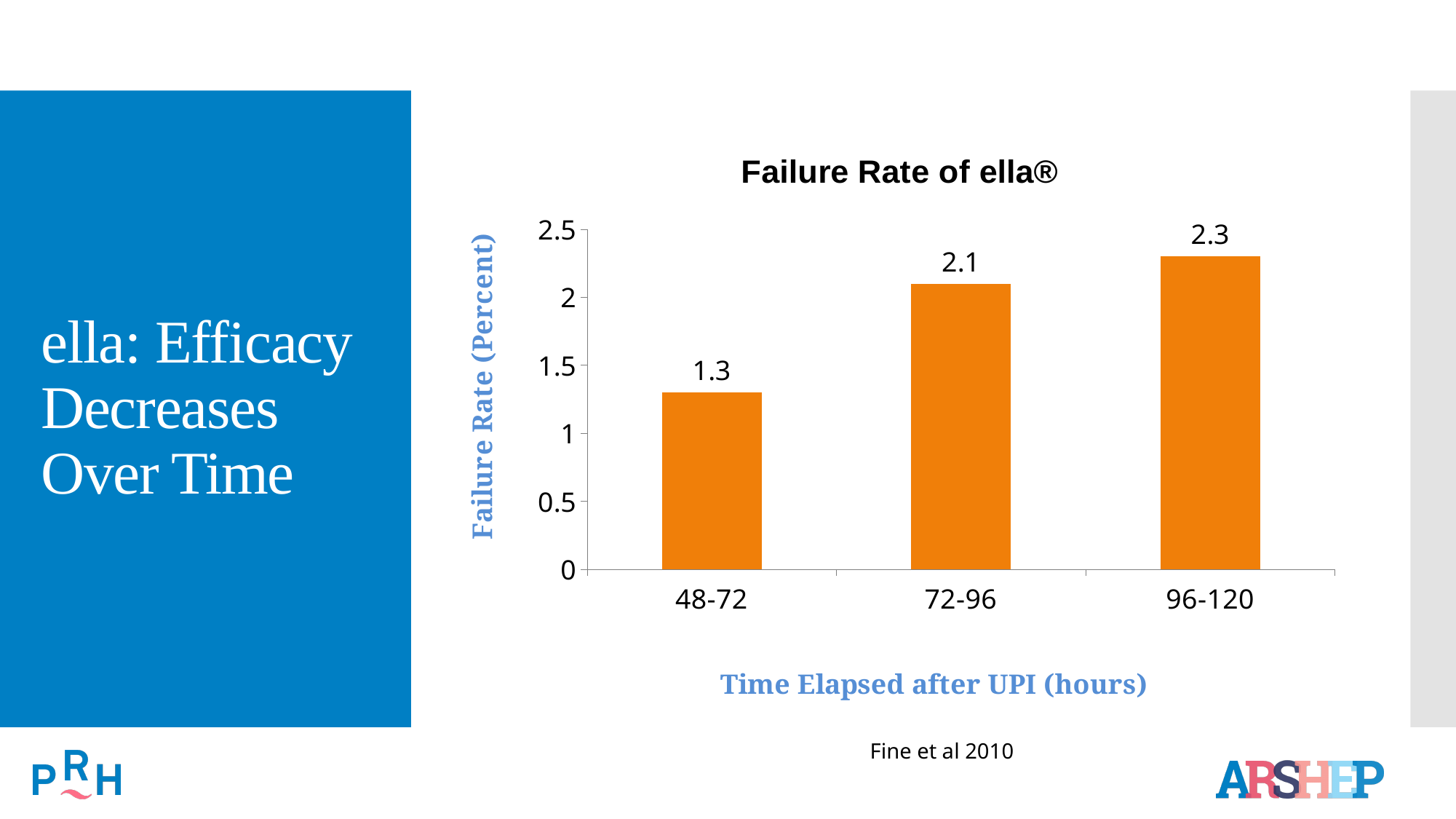
Which time interval has the highest failure rate? 96-120 What is the failure rate for the 96-120 hour interval? 2.3 What is the difference in failure rate between the 96-120 and 48-72 hour intervals? 1.0 What kind of chart is shown on the slide? bar chart What is the difference in failure rate between the 72-96 and 48-72 hour intervals? 0.8 Does the failure rate rise or fall as time elapsed after UPI increases? rise How many time intervals are shown in the chart? 3 Is the failure rate for the 48-72 hour interval greater or less than 1.5? less What is the failure rate for the 72-96 hour interval? 2.1 Which has a higher failure rate, 72-96 hours or 48-72 hours? 72-96 What is the failure rate for the 48-72 hour interval? 1.3 Which time interval has the lowest failure rate? 48-72